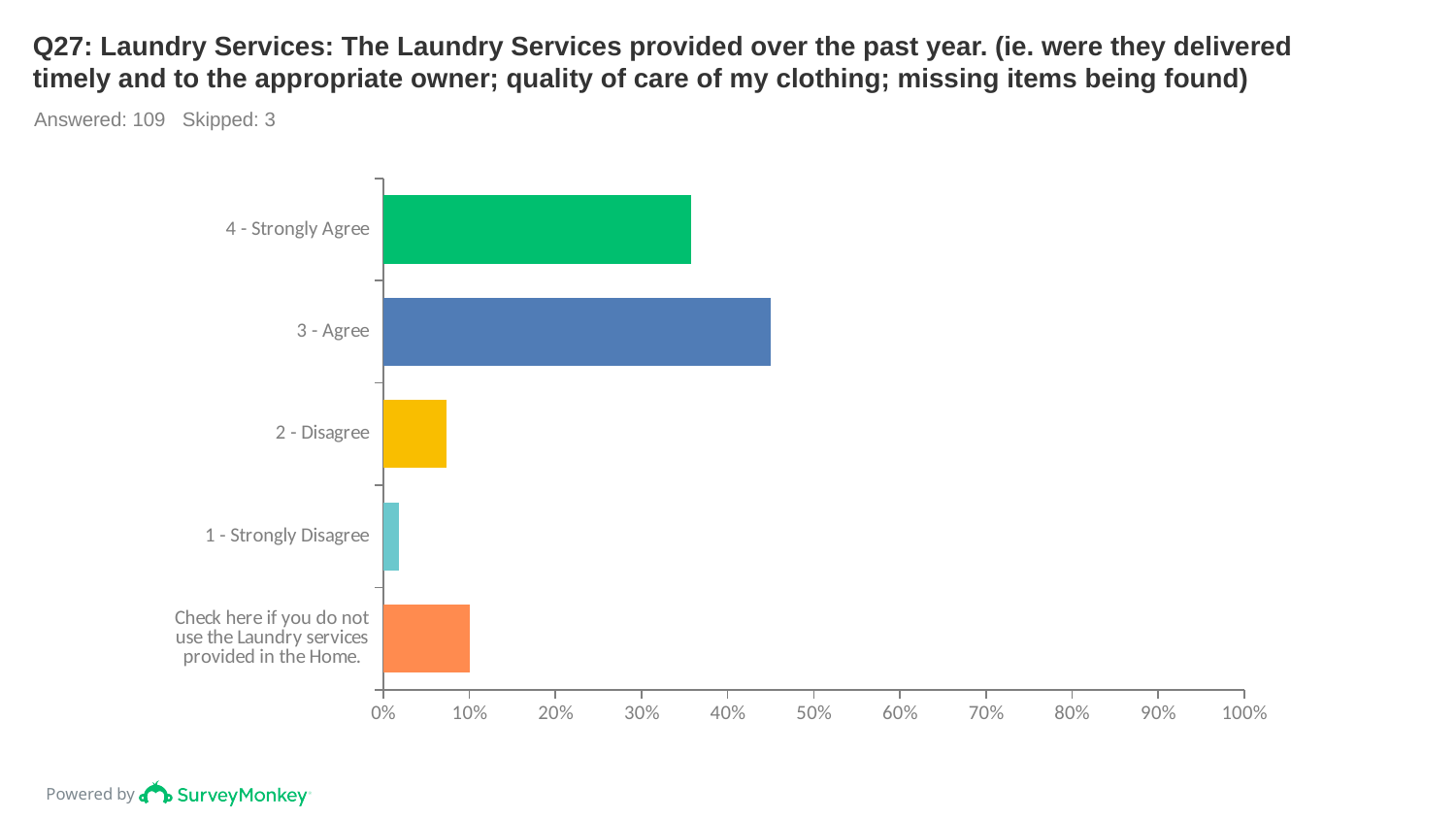
What kind of chart is shown on the slide? bar chart Is the value for 3 - Agree greater or less than 40%? greater How many respondents answered this question according to the slide? 109 How many categories are plotted in the chart? 5 What is the maximum value shown on the horizontal axis? 100% Which category has the highest value? 3 - Agree Is the value for 1 - Strongly Disagree greater or less than 10%? less Is the value for 2 - Disagree greater or less than 10%? less Which is larger, the value for 2 - Disagree or the value for 'Check here if you do not use the Laundry services provided in the Home.'? Check here if you do not use the Laundry services provided in the Home. Which is larger, the value for 4 - Strongly Agree or the value for 3 - Agree? 3 - Agree Which category has the lowest value? 1 - Strongly Disagree